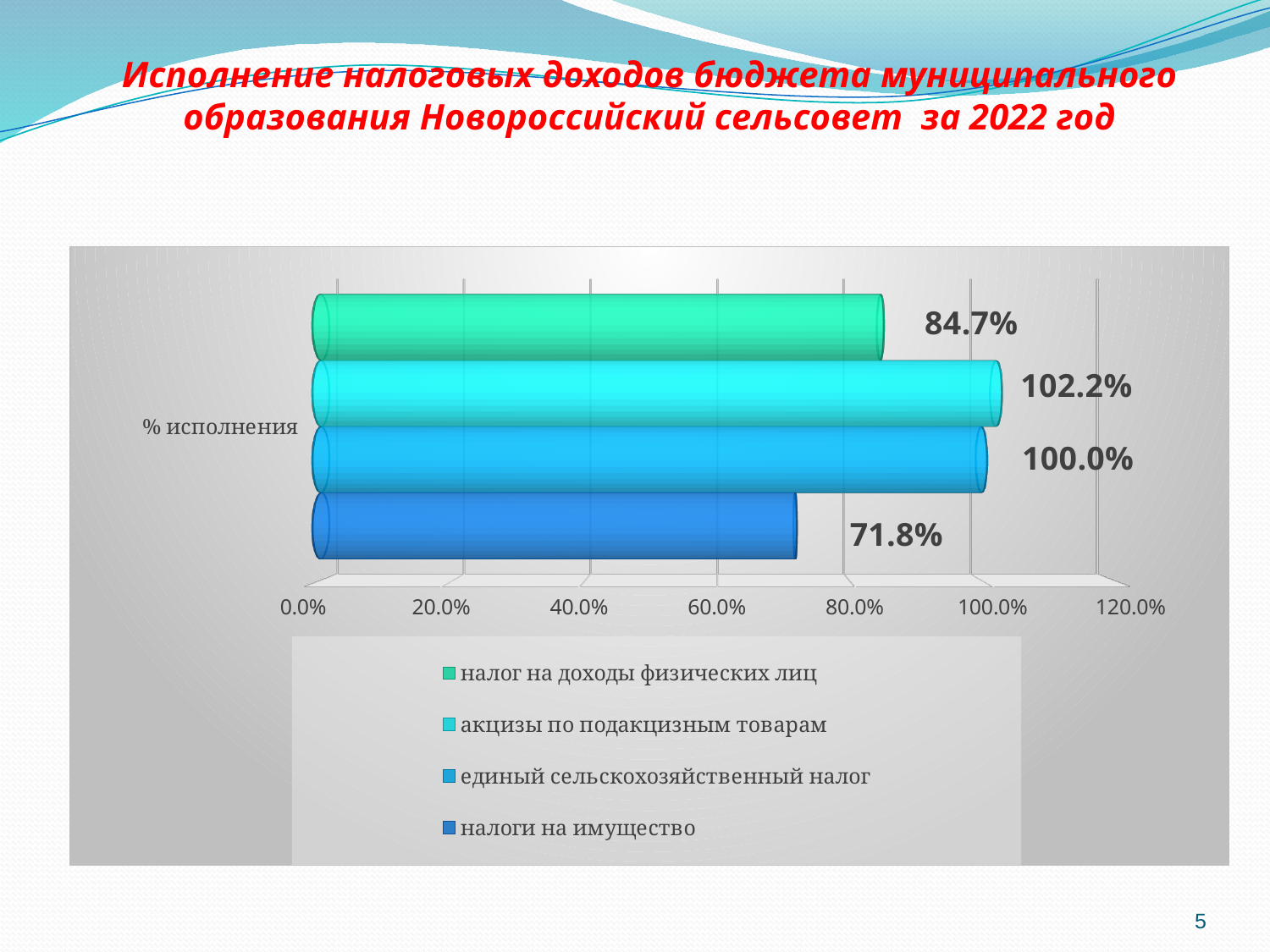
What is the difference between the values for акцизы по подакцизным товарам and налоги на имущество? 30.4% Which series has the lowest value? налоги на имущество What is the value for акцизы по подакцизным товарам? 102.2% What is the category label shown on the vertical axis of the chart? % исполнения What kind of chart is shown on the slide? bar chart Which series has the highest value? акцизы по подакцизным товарам What is the value for единый сельскохозяйственный налог? 100.0% What is the value for налог на доходы физических лиц? 84.7% Which is larger, the value for налог на доходы физических лиц or the value for единый сельскохозяйственный налог? единый сельскохозяйственный налог How many series does the legend list? 4 What is the value for налоги на имущество? 71.8% What is the difference between the values for налог на доходы физических лиц and налоги на имущество? 12.9%